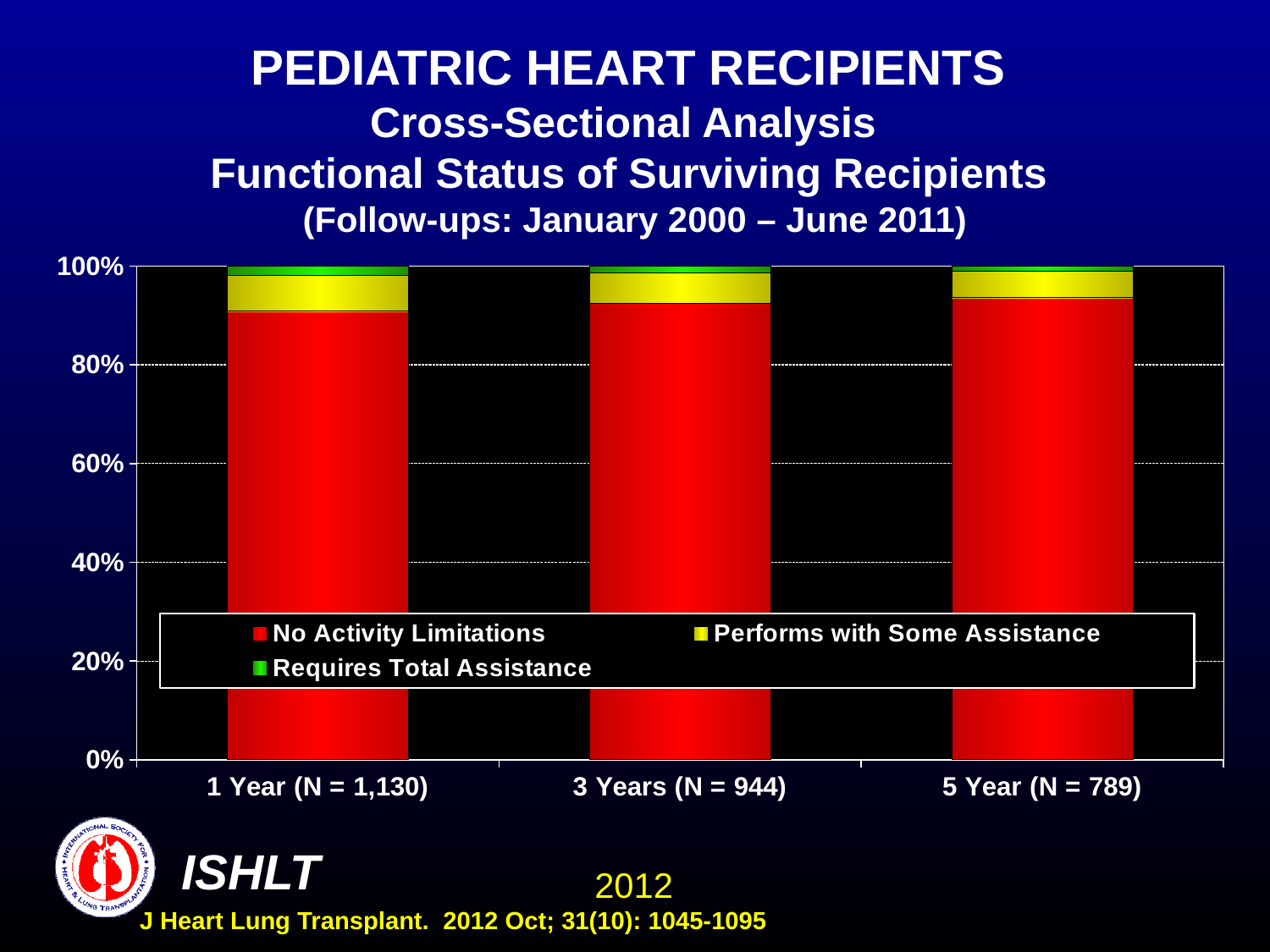
Which series makes up the largest share of each bar? No Activity Limitations How many series does the legend list? 3 Is the value for Performs with Some Assistance at 3 Years greater or less than 20%? less How many follow-up time categories are shown on the x axis? 3 Which colour represents Requires Total Assistance in the legend? Green Is the value for Requires Total Assistance at 1 Year greater or less than 20%? less What kind of chart is shown on the slide? Stacked bar chart Is the value for No Activity Limitations at 5 Year greater or less than 80%? greater Is the value for No Activity Limitations larger at 1 Year or at 5 Year? 5 Year What is the N shown for the 3 Years category? 944 What is the total of the stacked bar for 3 Years (N = 944)? 100%